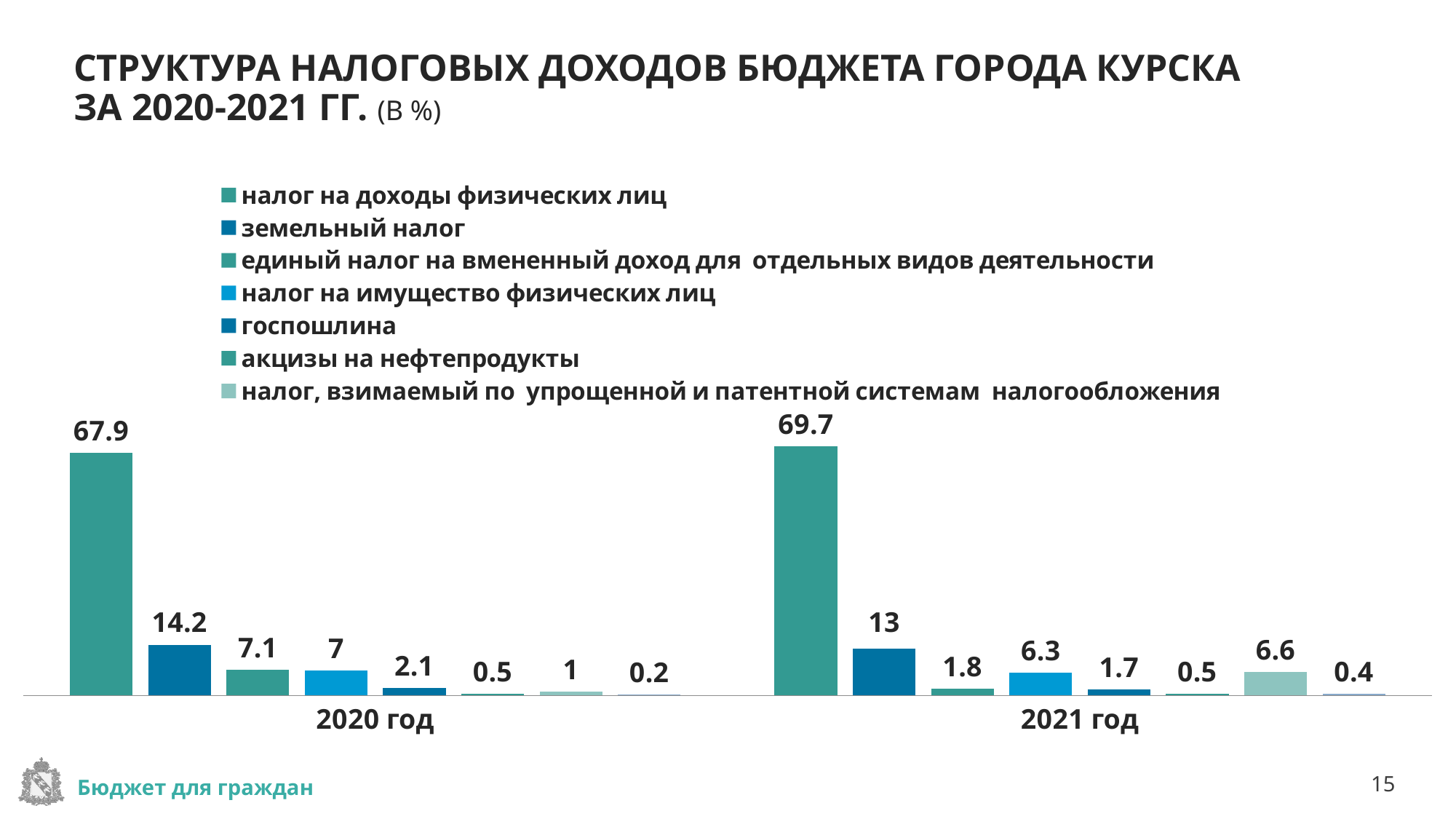
What is the value for налог на доходы физических лиц in 2021 год? 69.7 What kind of chart is shown on the slide? bar chart Which is larger: единый налог на вмененный доход для отдельных видов деятельности in 2020 год or in 2021 год? 2020 год What is the value for налог на имущество физических лиц in 2020 год? 7 What is the value for налог, взимаемый по упрощенной и патентной системам налогообложения in 2021 год? 6.6 What is the difference between the земельный налог values for 2020 год and 2021 год? 1.2 Which series has the highest value in 2021 год? налог на доходы физических лиц Does the value for налог на доходы физических лиц rise or fall from 2020 год to 2021 год? rise What is the value for госпошлина in 2020 год? 2.1 What is the value for налог на доходы физических лиц in 2020 год? 67.9 What is the value for земельный налог in 2021 год? 13 How many series does the legend list? 7